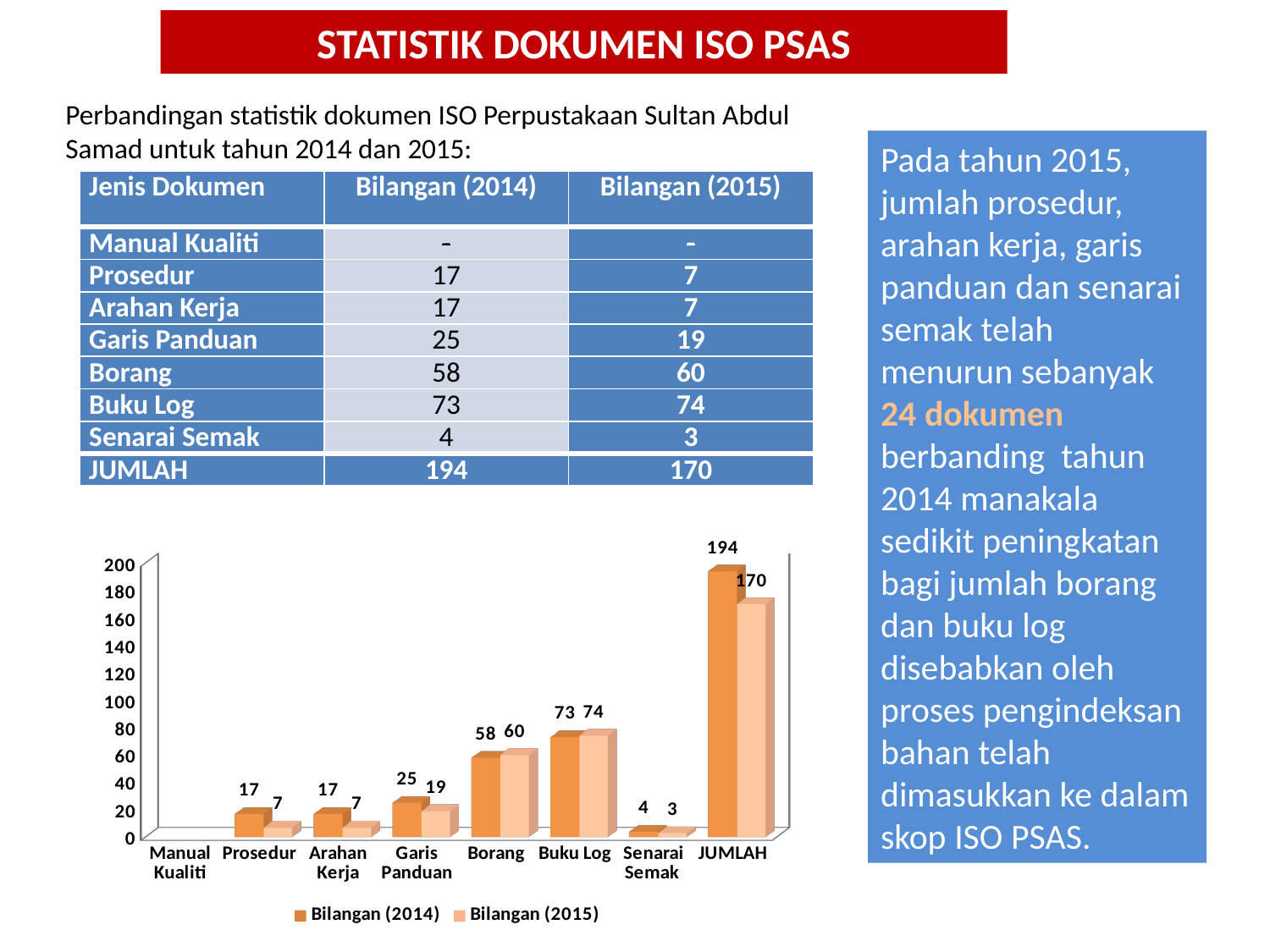
What kind of chart is shown on the slide? bar chart What is the value for Garis Panduan in the Bilangan (2015) series? 19 What is the value for JUMLAH in the Bilangan (2015) series? 170 What is the difference between the Bilangan (2014) and Bilangan (2015) values for JUMLAH? 24 How many categories are shown on the x axis of the chart? 8 Is the Bilangan (2014) value for Garis Panduan greater or less than 40? less Which category has the lowest value in the Bilangan (2015) series among those with a plotted bar? Senarai Semak Which is larger for Buku Log: the Bilangan (2014) value or the Bilangan (2015) value? Bilangan (2015) What is the difference between the Bilangan (2014) and Bilangan (2015) values for Prosedur? 10 Excluding JUMLAH, which category has the highest value in the Bilangan (2014) series? Buku Log What is the value for Borang in the Bilangan (2014) series? 58 How many series does the chart legend list? 2